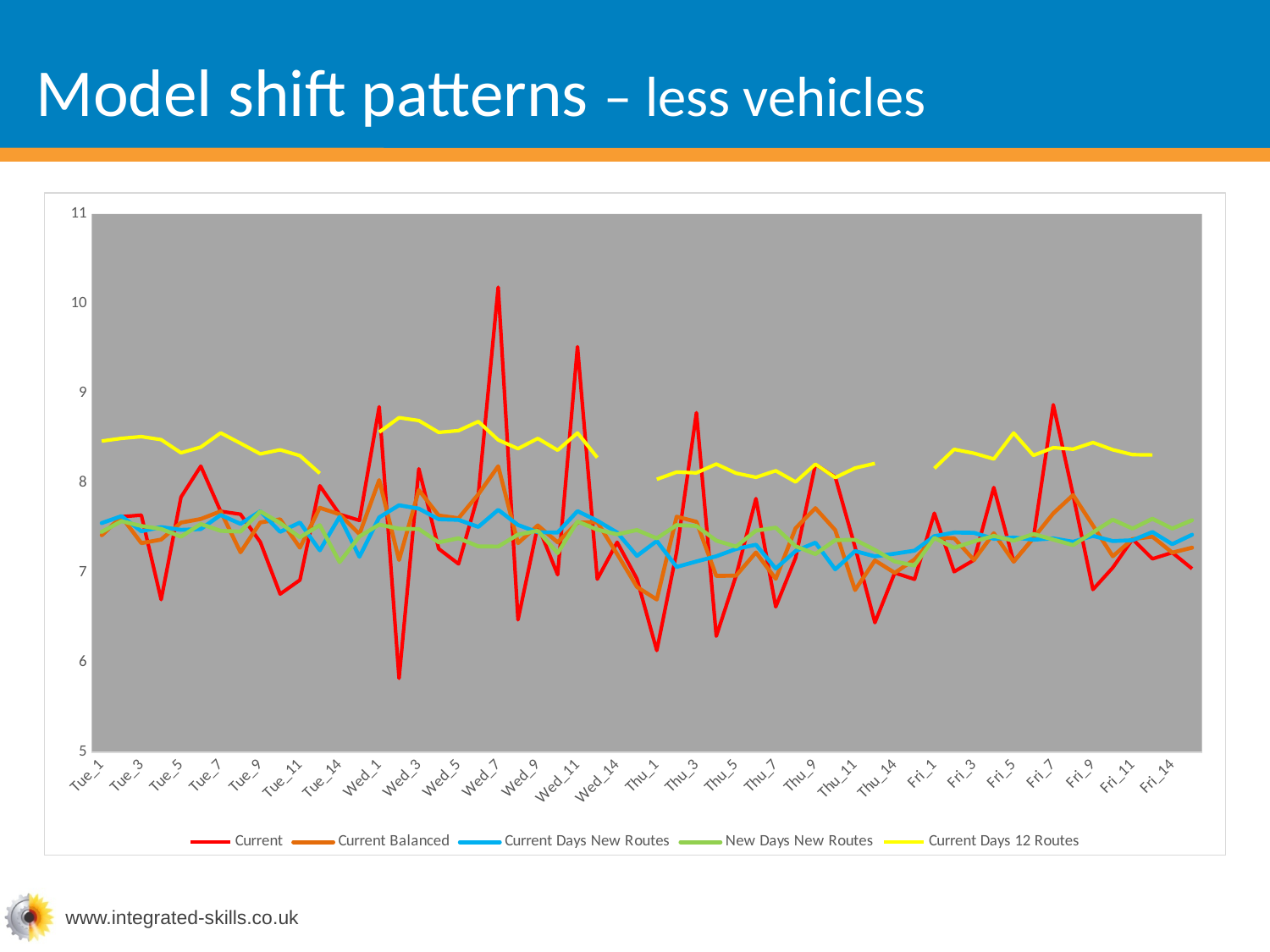
Is the lowest value of the Current series greater or less than 6? less At Wed_7, which is larger: the Current series or the Current Days 12 Routes series? Current Is the value of the Current Days 12 Routes series at Tue_1 greater or less than 8? greater Which series is drawn in yellow? Current Days 12 Routes How many series does the legend list? 5 How many weekdays (Tue, Wed, Thu, Fri) are covered along the x axis? 4 Is the highest value of the Current series greater or less than 10? greater At Tue_1, which is larger: the Current series or the Current Days 12 Routes series? Current Days 12 Routes Which series is drawn in red? Current What kind of chart is shown on the slide? line chart Which series reaches the highest peak on the chart? Current